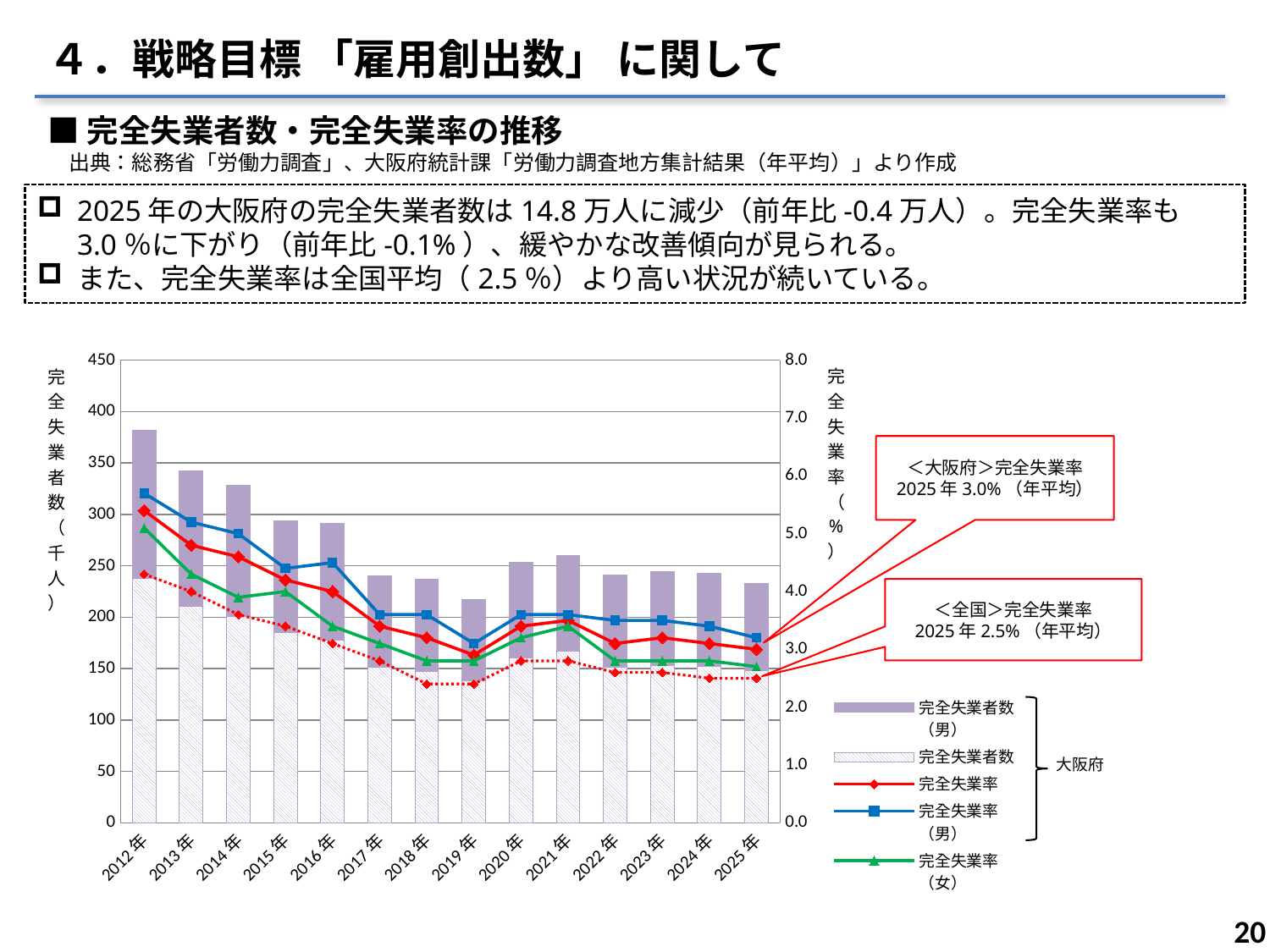
Does the 完全失業率 line (red) generally rise or fall from 2012年 to 2025年? Fall Is the 完全失業率（男） value for 2012年 greater or less than 5.0? greater Is the top of the stacked bar for 2012年 greater or less than 350? greater Which year has the shortest stacked bar for 完全失業者数? 2019年 What kind of chart is shown on the slide? A combined bar and line chart How many series does the chart's legend list? 5 Which year has the tallest stacked bar for 完全失業者数? 2012年 According to the annotation, what is the 大阪府 完全失業率 for 2025年? 3.0% What is the difference between the 2025年 大阪府 完全失業率 (3.0%) and the 全国 完全失業率 (2.5%) shown in the annotations? 0.5% In 2012年, which is higher: 完全失業率（男） or 完全失業率（女）? 完全失業率（男） How many years are shown on the x axis of the chart? 14 According to the annotation, what is the 全国 完全失業率 for 2025年? 2.5%